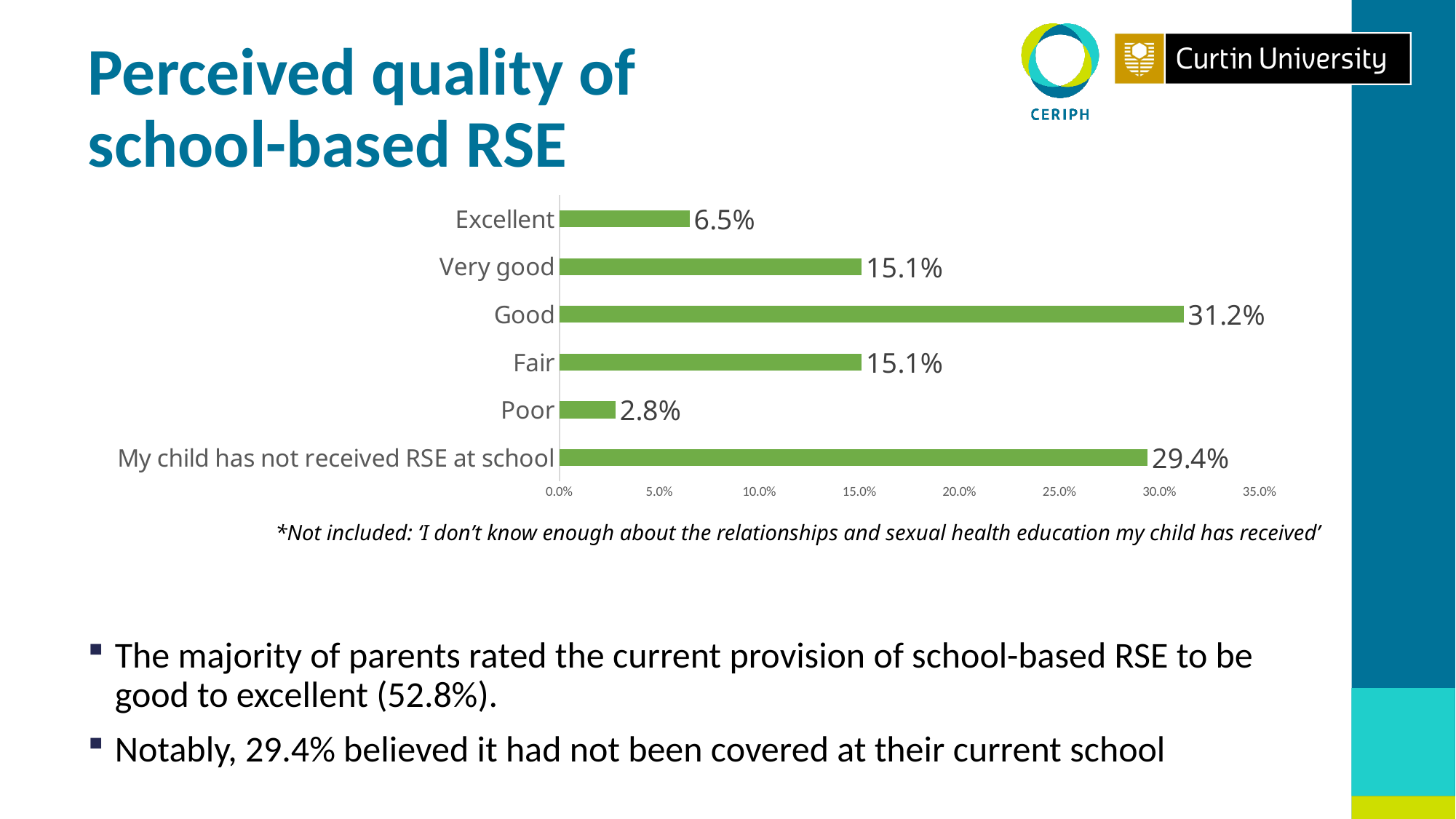
What is the maximum value shown on the x axis? 35.0% What is the value for Poor? 2.8% What percentage of parents said 'My child has not received RSE at school'? 29.4% Which category has the lowest value? Poor How many categories are shown in the chart? 6 What is the value for Excellent? 6.5% What percentage of parents rated school-based RSE as Good? 31.2% Which category has the highest value? Good Which is larger, the value for Good or the value for 'My child has not received RSE at school'? Good What is the difference between the values for Good and Very good? 16.1% What kind of chart is shown on the slide? Bar chart What is the difference between the values for Excellent and Poor? 3.7%